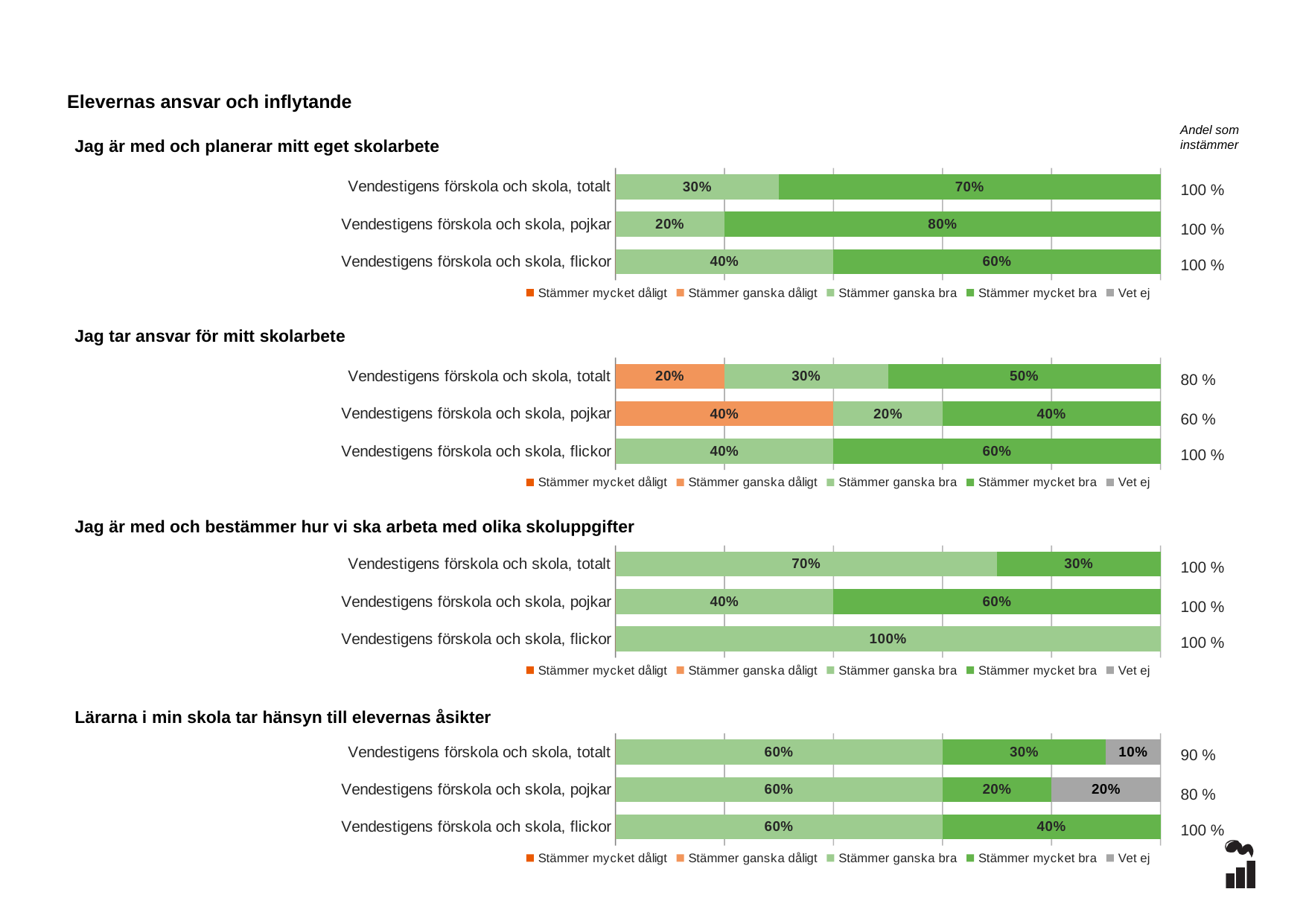
In the chart 'Jag är med och planerar mitt eget skolarbete', what is the 'Stämmer mycket bra' value for 'Vendestigens förskola och skola, pojkar'? 80% In the chart 'Lärarna i min skola tar hänsyn till elevernas åsikter', which is larger: the 'Stämmer mycket bra' value for 'pojkar' or for 'flickor'? Vendestigens förskola och skola, flickor How many series does the legend of the chart 'Jag är med och planerar mitt eget skolarbete' list? 5 In the chart 'Jag är med och bestämmer hur vi ska arbeta med olika skoluppgifter', which category has the highest 'Stämmer ganska bra' value? Vendestigens förskola och skola, flickor In the chart 'Lärarna i min skola tar hänsyn till elevernas åsikter', what is the 'Vet ej' value for 'Vendestigens förskola och skola, totalt'? 10% In the chart 'Jag är med och planerar mitt eget skolarbete', which category has the lowest 'Stämmer mycket bra' value? Vendestigens förskola och skola, flickor In the chart 'Jag tar ansvar för mitt skolarbete', what is the 'Andel som instämmer' value shown for 'Vendestigens förskola och skola, pojkar'? 60 % In the chart 'Jag tar ansvar för mitt skolarbete', what is the 'Stämmer ganska dåligt' value for 'Vendestigens förskola och skola, pojkar'? 40% How many categories (bars) does the chart 'Jag tar ansvar för mitt skolarbete' show? 3 In the chart 'Jag tar ansvar för mitt skolarbete', what is the total of the 'Stämmer ganska bra' and 'Stämmer mycket bra' segments for 'Vendestigens förskola och skola, totalt'? 80% What kind of chart is 'Lärarna i min skola tar hänsyn till elevernas åsikter'? Stacked bar chart In the chart 'Jag tar ansvar för mitt skolarbete', what is the difference between the 'Stämmer mycket bra' values for 'totalt' and 'pojkar'? 10%